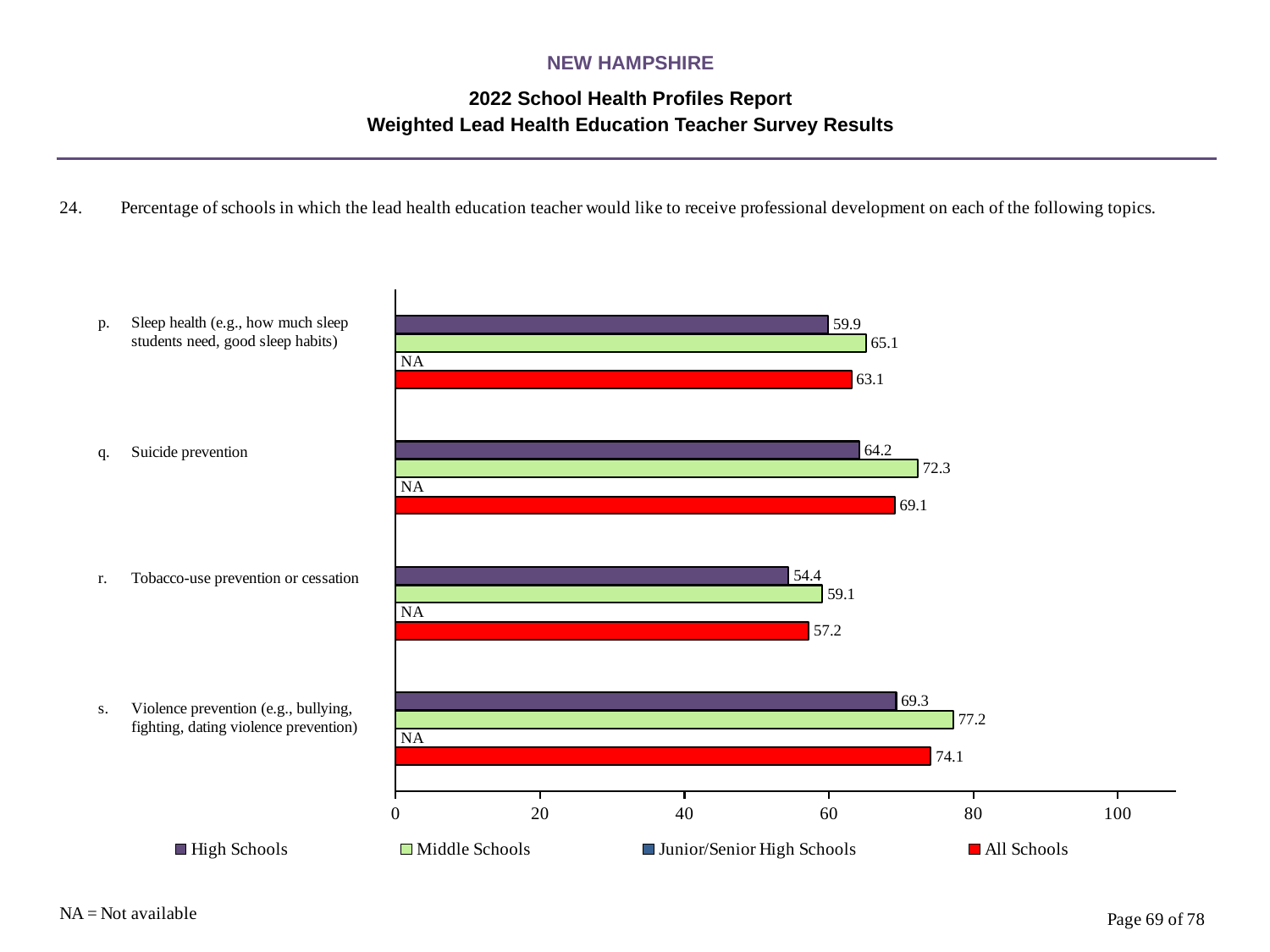
What is the value for Middle Schools for Suicide prevention? 72.3 Which is larger for Suicide prevention: the High Schools value or the All Schools value? All Schools What is the value for All Schools for Sleep health? 63.1 What kind of chart is shown on the slide? Bar chart What is the difference between the Middle Schools and High Schools values for Violence prevention? 7.9 Which topic has the lowest value for All Schools? Tobacco-use prevention or cessation What is the value for High Schools for Tobacco-use prevention or cessation? 54.4 What value is shown for Junior/Senior High Schools for each topic? NA Which topic has the highest value for Middle Schools? Violence prevention (e.g., bullying, fighting, dating violence prevention) How many series does the legend list? 4 How many topics are shown on the chart? 4 What colour are the All Schools bars? Red